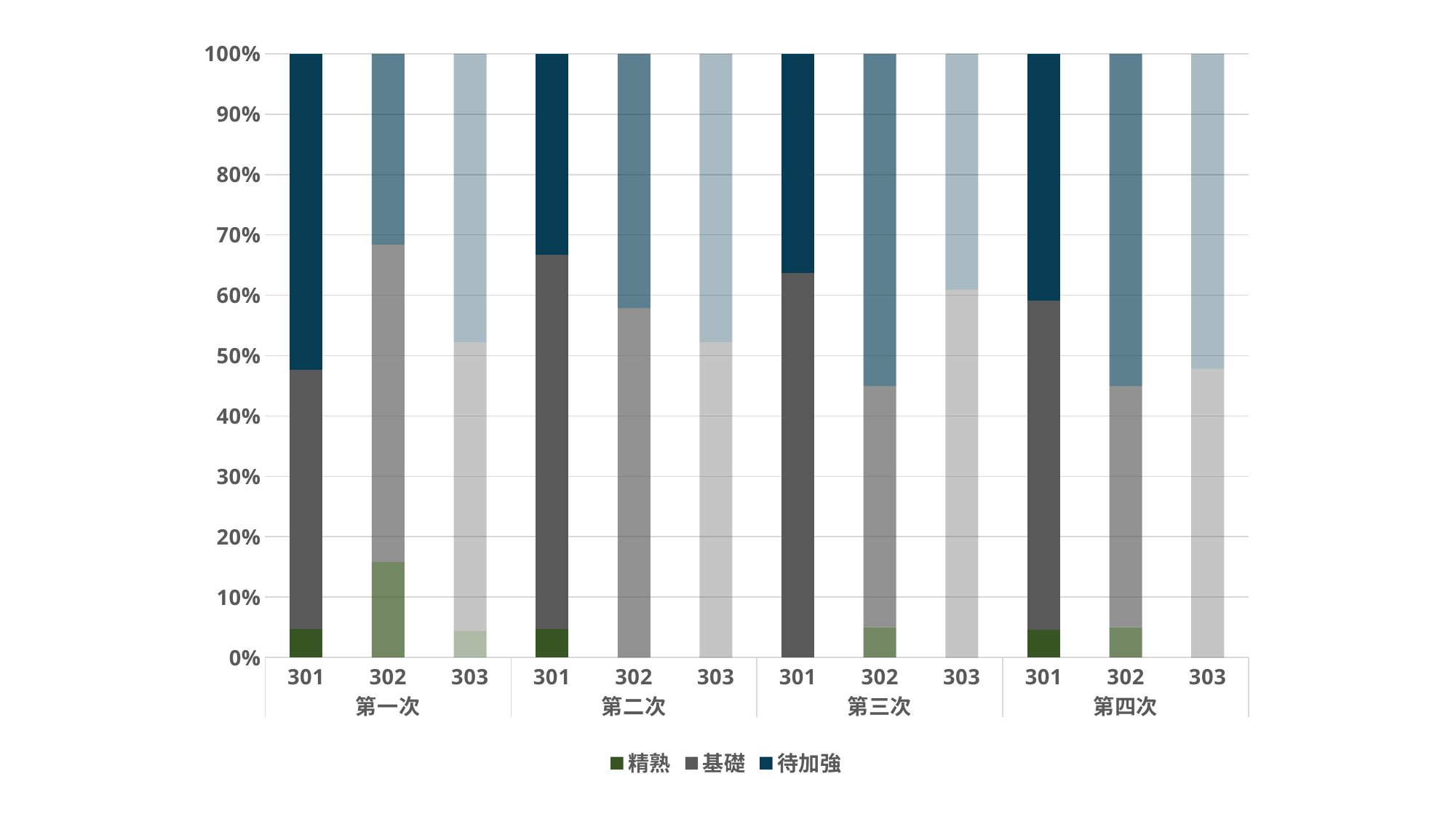
Is the 待加強 share for class 301 in 第二次 greater or less than 40%? less Which series is plotted at the top of each stacked bar? 待加強 Is the 精熟 share for class 302 in 第一次 greater or less than 10%? greater How many test rounds (第一次 to 第四次) are shown along the x axis? 4 How many series does the legend list? 3 What are the three series named in the legend? 精熟, 基礎, 待加強 Is the 待加強 share for class 302 in 第一次 greater or less than 40%? less How many stacked bars are plotted in total? 12 In 第一次, which has the larger 精熟 share, class 301 or class 302? 302 In 第一次, which class has the largest 精熟 share? 302 What kind of chart is shown on the slide? Stacked bar chart